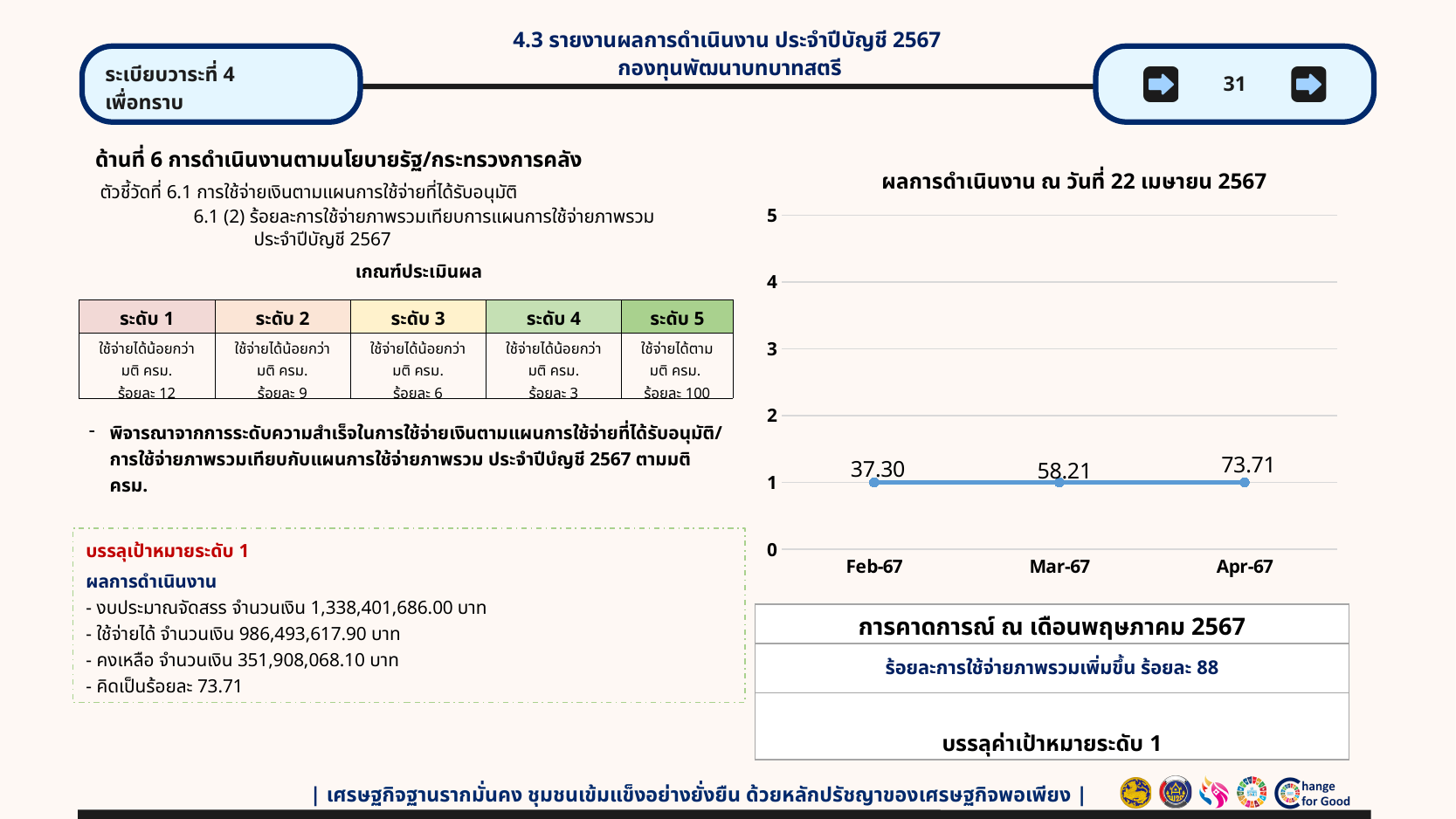
What is the difference between the data labels for Mar-67 and Feb-67? 20.91 How many months are shown on the x axis of the chart? 3 Which month has the highest data label on the chart? Apr-67 What is the title of the chart? ผลการดำเนินงาน ณ วันที่ 22 เมษายน 2567 Do the data labels rise or fall from Feb-67 to Apr-67? rise Which month has the lowest data label on the chart? Feb-67 What type of chart is shown on the slide? line chart Which has the larger data label, Mar-67 or Apr-67? Apr-67 What is the data label shown for Mar-67? 58.21 What is the difference between the data labels for Apr-67 and Feb-67? 36.41 What is the data label shown for Apr-67? 73.71 What is the data label shown for Feb-67? 37.30